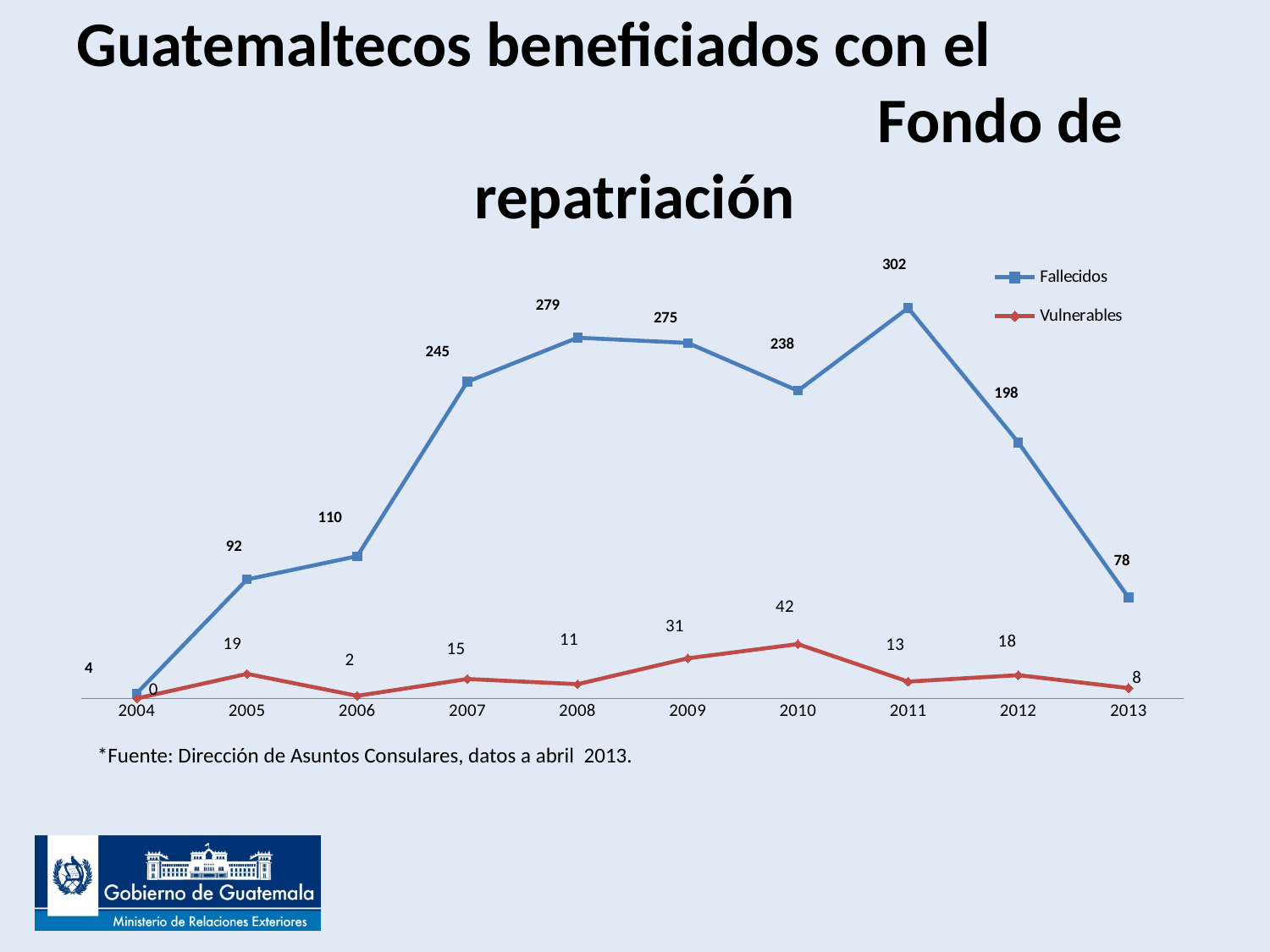
Which series is drawn in red? Vulnerables What type of chart is shown on the slide? Line chart What is the value for Vulnerables in 2010? 42 What is the value for Fallecidos in 2013? 78 In which year is the Vulnerables value lowest? 2004 How many series does the legend list? 2 What is the value for Fallecidos in 2011? 302 How many years are plotted on the x axis? 10 In which year is the Fallecidos value highest? 2011 What is the difference between the Fallecidos values for 2008 and 2013? 201 Which is larger, the Vulnerables value for 2005 or for 2006? 2005 Does the Fallecidos series rise or fall from 2011 to 2013? Fall